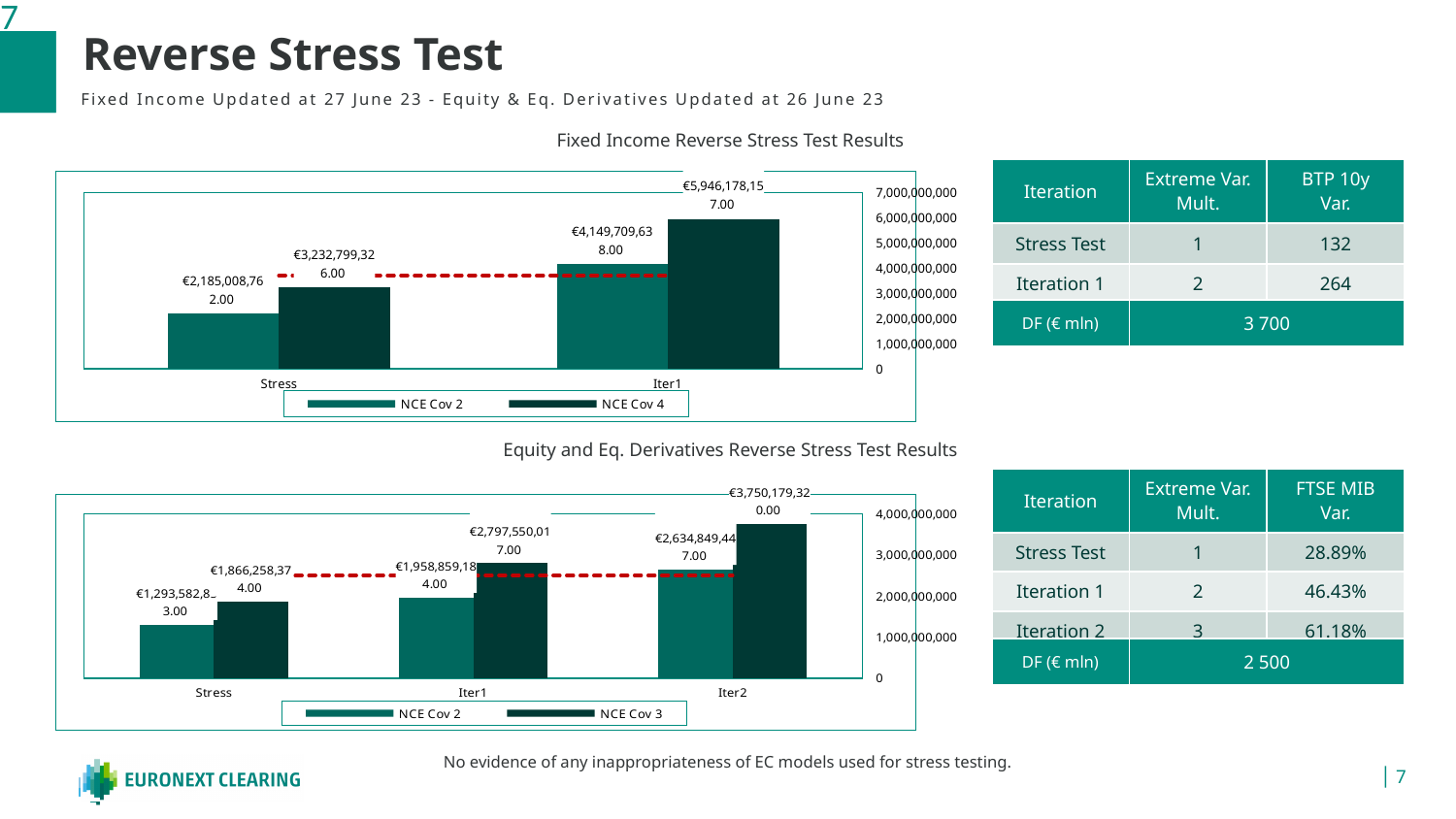
In the Equity and Eq. Derivatives Reverse Stress Test Results chart, is the NCE Cov 2 value for Stress greater or less than 2,000,000,000? less How many categories are shown on the x axis of the Fixed Income Reverse Stress Test Results chart? 2 In the Equity and Eq. Derivatives Reverse Stress Test Results chart, do the NCE Cov 2 values rise or fall from Stress to Iter2? Rise In the Equity and Eq. Derivatives Reverse Stress Test Results chart, which bar is the highest? NCE Cov 3 at Iter2 How many series does the legend of the Fixed Income Reverse Stress Test Results chart list? 2 What are the legend entries of the Equity and Eq. Derivatives Reverse Stress Test Results chart? NCE Cov 2 and NCE Cov 3 In the Fixed Income Reverse Stress Test Results chart, is the NCE Cov 4 value for Iter1 greater or less than 5,000,000,000? greater How many categories are shown on the x axis of the Equity and Eq. Derivatives Reverse Stress Test Results chart? 3 In the Fixed Income Reverse Stress Test Results chart, which bar is the highest? NCE Cov 4 at Iter1 In the Fixed Income Reverse Stress Test Results chart, which is larger: NCE Cov 4 at Stress or NCE Cov 2 at Iter1? NCE Cov 2 at Iter1 In the Fixed Income Reverse Stress Test Results chart, which bar is the lowest? NCE Cov 2 at Stress What kind of chart is the Fixed Income Reverse Stress Test Results chart? Bar chart